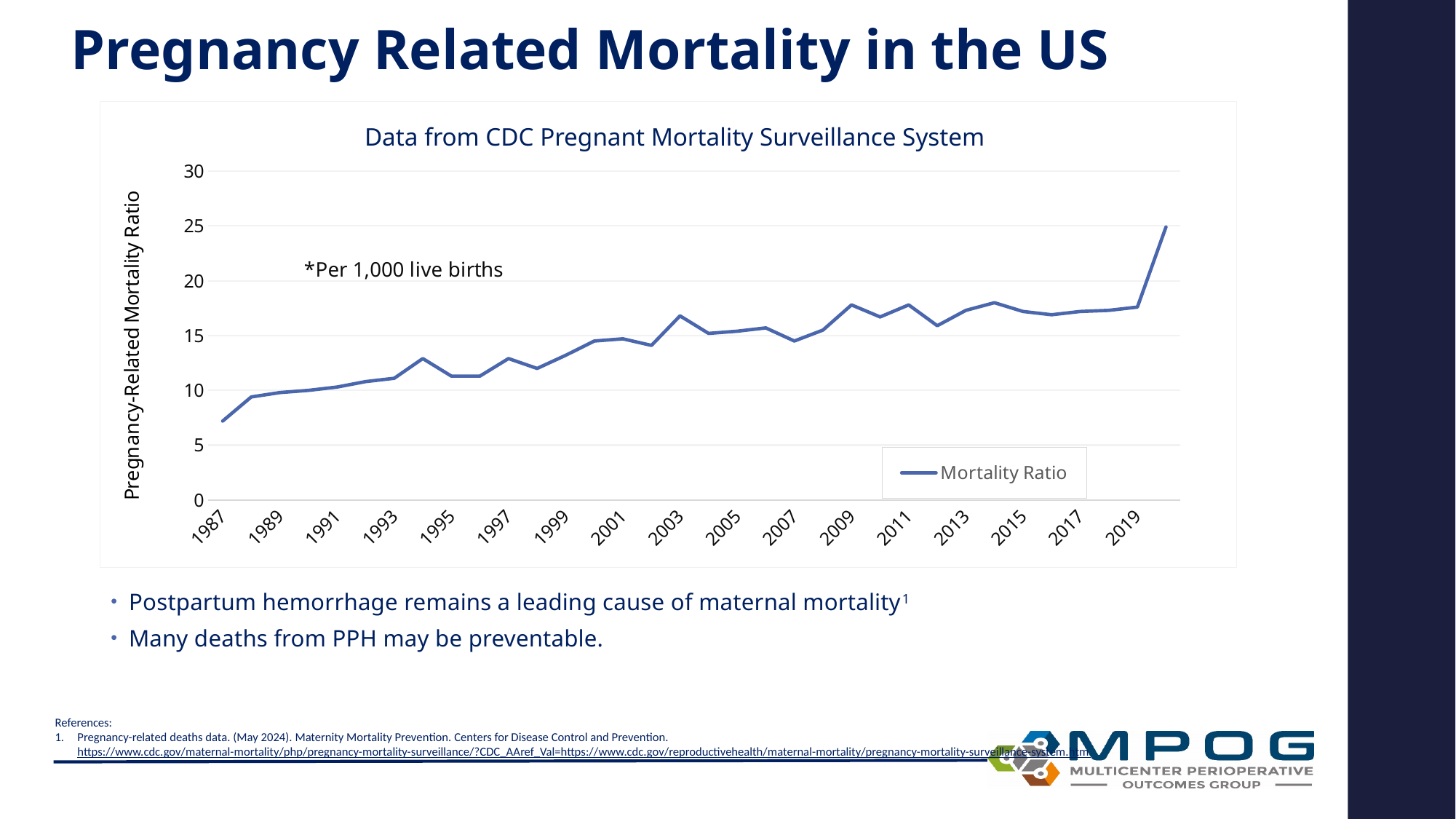
Is the mortality ratio for 1987 greater or less than 10? less Which year has the lowest pregnancy-related mortality ratio? 1987 Overall, does the mortality ratio rise or fall from 1987 to the end of the series? Rise What is the name of the series shown in the legend? Mortality Ratio Is the mortality ratio for 2019 greater or less than 20? less Which year has the larger mortality ratio, 1999 or 2011? 2011 Is the mortality ratio for 2003 greater or less than 15? greater Which year has the larger mortality ratio, 1989 or 2009? 2009 What kind of chart is shown on the slide? Line chart How many series does the chart legend list? 1 What is the title of the chart? Data from CDC Pregnant Mortality Surveillance System